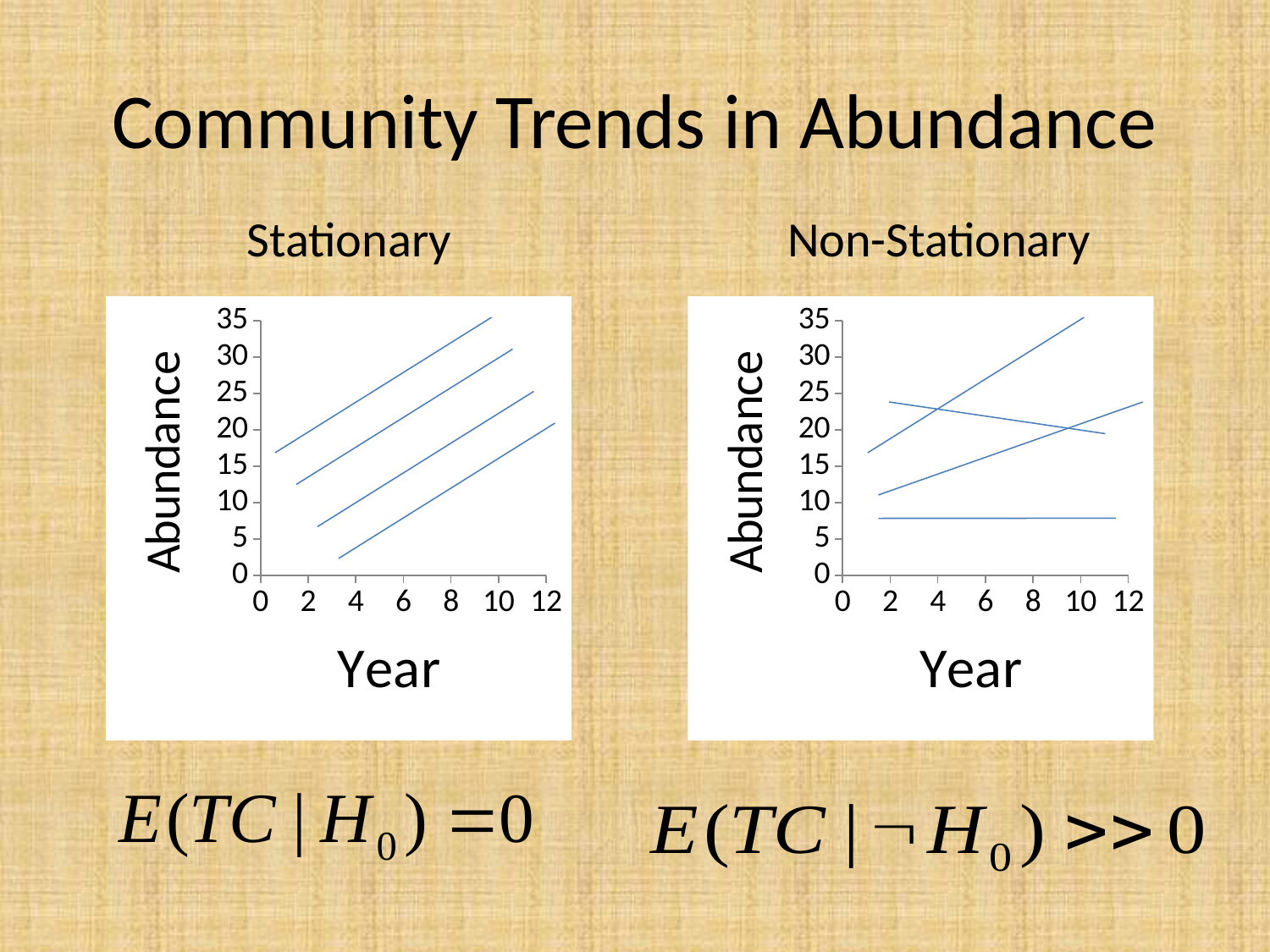
In the Stationary chart, is the lowest starting abundance of the bottom line greater or less than 5? less What kind of chart is the Stationary chart? line chart What kind of chart is the Non-Stationary chart? line chart In the Non-Stationary chart, is the flat line's abundance greater or less than 10? less How many lines are plotted in the Non-Stationary chart? 4 What is the label of the x axis on the Non-Stationary chart? Year In the Stationary chart, do the lines rise or fall as Year increases? rise In the Stationary chart, is the highest abundance reached by the top line greater or less than 30? greater What is the label of the y axis on the Stationary chart? Abundance How many lines are plotted in the Stationary chart? 4 In the Non-Stationary chart, does the line that starts at about 17 abundance at year 1 rise or fall as Year increases? rise In the Non-Stationary chart, does the line that starts at about 24 abundance at year 2 rise or fall as Year increases? fall